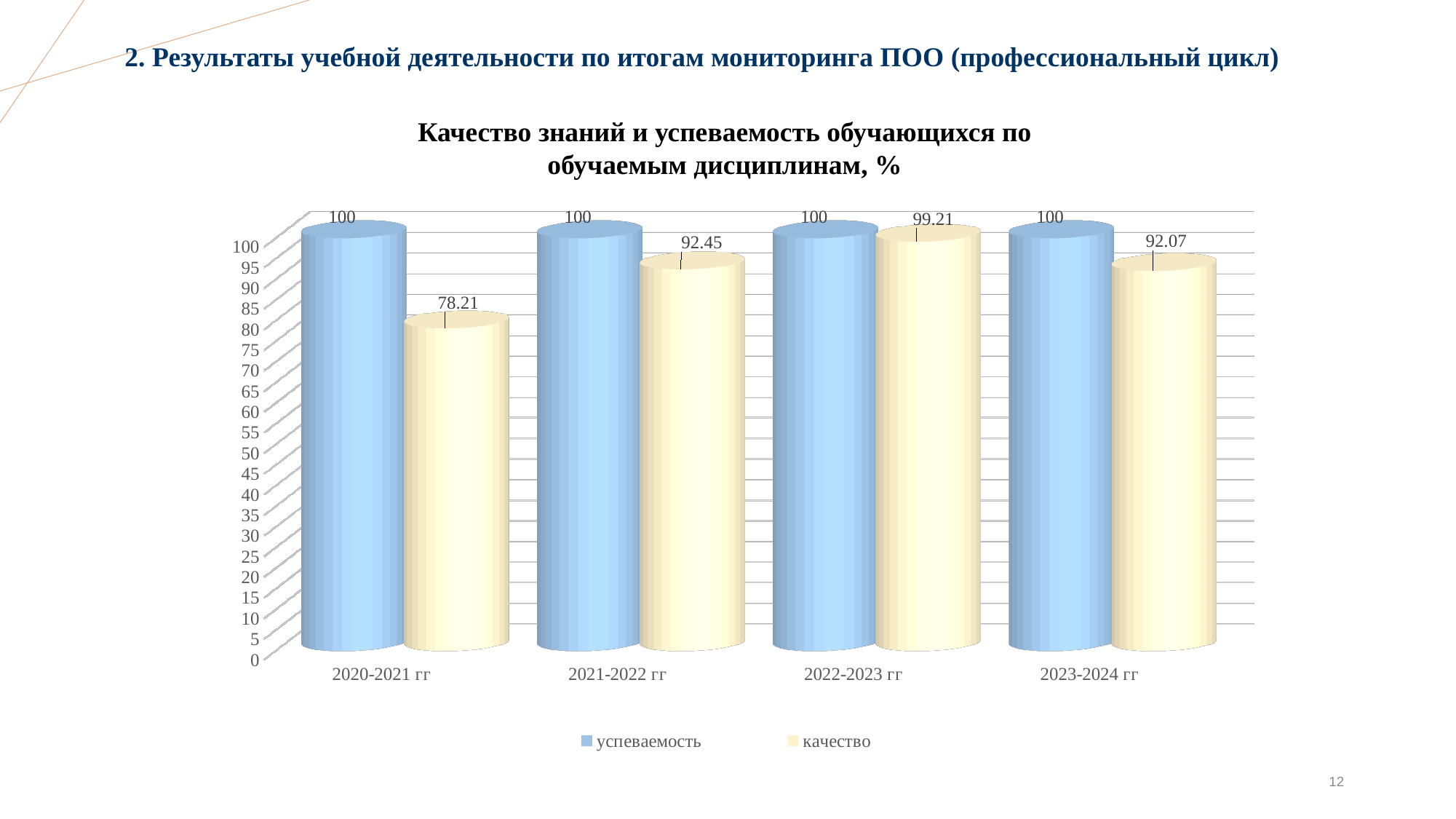
How many year categories are shown on the x axis? 4 What is the value of качество for 2022-2023 гг? 99.21 What is the title of the chart? Качество знаний и успеваемость обучающихся по обучаемым дисциплинам, % In which year is качество the lowest? 2020-2021 гг Which is larger: качество in 2021-2022 гг or качество in 2023-2024 гг? 2021-2022 гг How many series does the legend list? 2 What is the value of успеваемость for 2023-2024 гг? 100 What is the value of качество for 2020-2021 гг? 78.21 In which year is качество the highest? 2022-2023 гг What is the difference between успеваемость and качество in 2023-2024 гг? 7.93 What is the value of качество for 2021-2022 гг? 92.45 What kind of chart is shown on the slide? bar chart